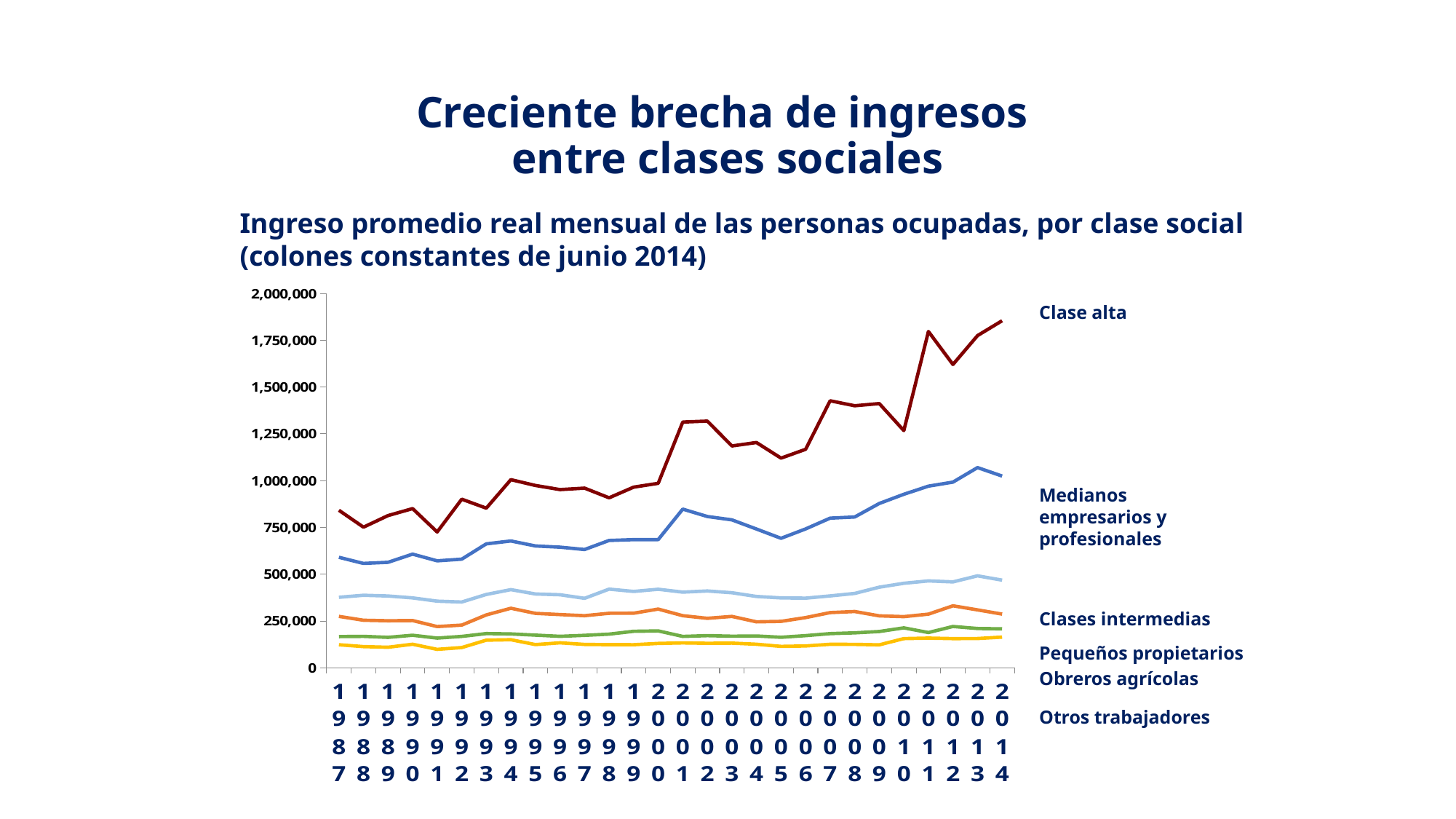
Is the value for Clase alta in 2007 greater or less than 1,250,000? greater What is the title of the chart? Ingreso promedio real mensual de las personas ocupadas, por clase social (colones constantes de junio 2014) Which social class has the highest income across the whole period? Clase alta Which social class has the lowest income across the whole period? Otros trabajadores What kind of chart is shown on the slide? Line chart Is the value for Clases intermedias in 1987 greater or less than 500,000? less In 2014, which is larger: the income of Clase alta or of Medianos empresarios y profesionales? Clase alta Is the value for Clase alta in 2014 greater or less than 1,750,000? greater How many years (data points) are plotted along the x axis? 28 Does the income of Clase alta rise or fall overall from 1987 to 2014? Rise How many social classes (series) are labelled on the chart? 6